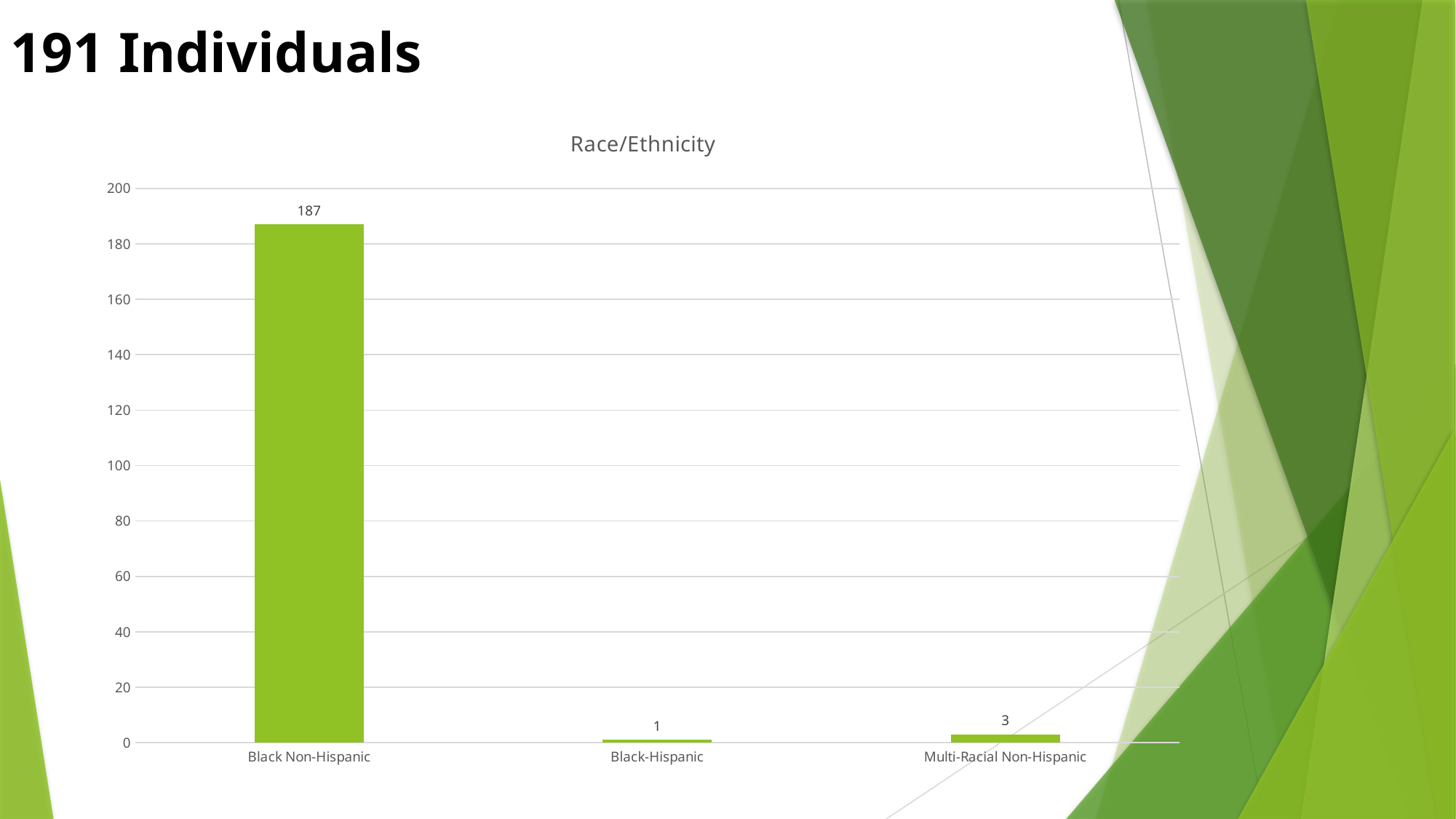
What kind of chart is shown on the slide? bar chart What is the difference between the values for Multi-Racial Non-Hispanic and Black-Hispanic? 2 What is the value for Black-Hispanic? 1 Which is larger, the value for Black-Hispanic or the value for Multi-Racial Non-Hispanic? Multi-Racial Non-Hispanic Which category has the highest value? Black Non-Hispanic What is the difference between the values for Black Non-Hispanic and Multi-Racial Non-Hispanic? 184 Which category has the lowest value? Black-Hispanic Is the value for Black Non-Hispanic greater or less than 180? greater What is the title of the chart? Race/Ethnicity What is the value for Black Non-Hispanic? 187 What is the value for Multi-Racial Non-Hispanic? 3 How many categories are shown on the x axis? 3